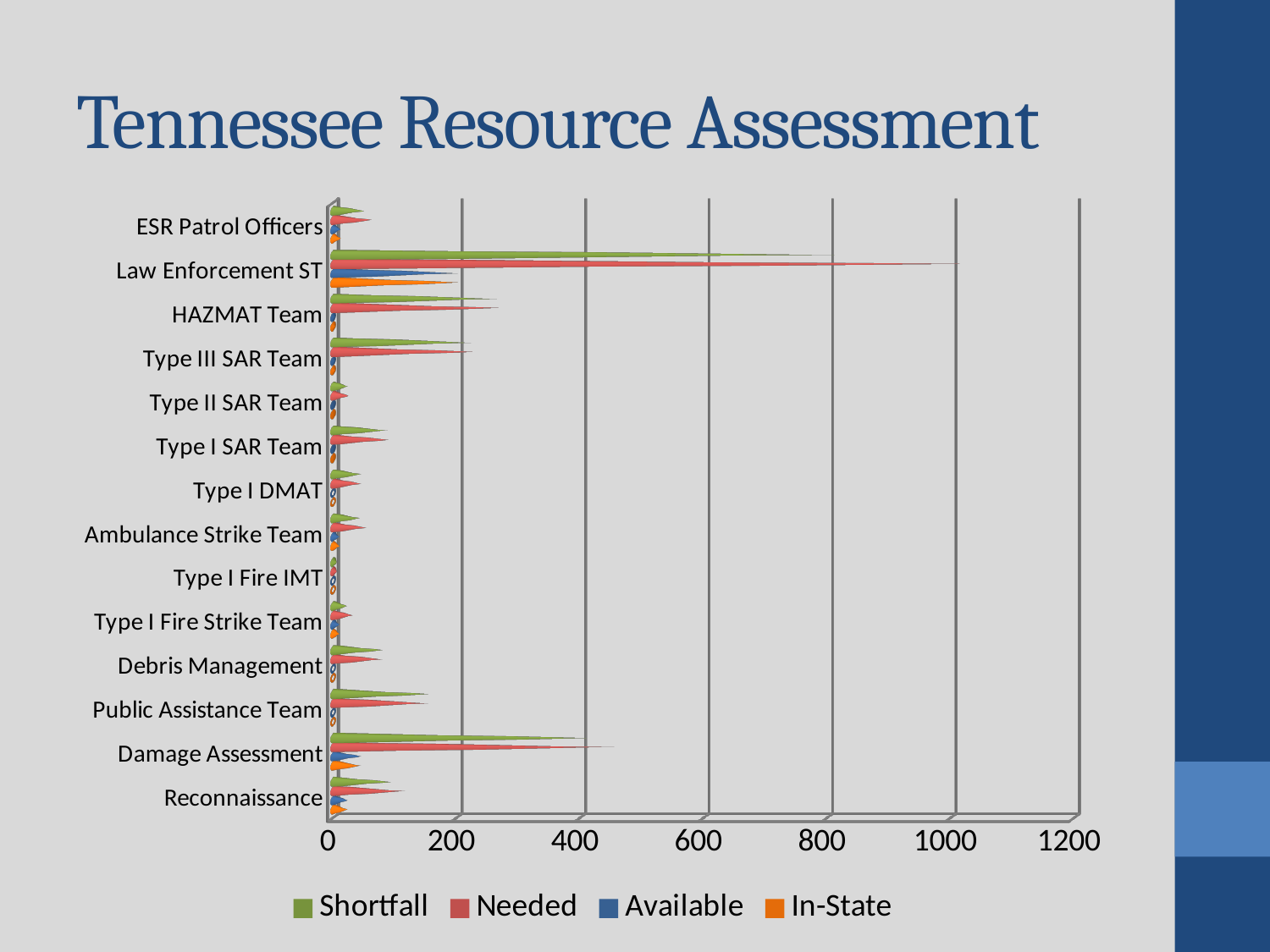
Which colour represents the In-State series in the legend? orange Which has the larger Needed value, Law Enforcement ST or Damage Assessment? Law Enforcement ST Is the Needed value for HAZMAT Team greater or less than 200? greater What is the title of the chart? Tennessee Resource Assessment Which category has the highest Needed value? Law Enforcement ST Is the Needed value for Damage Assessment greater or less than 400? greater How many series does the legend list? 4 How many categories are shown on the vertical axis of the chart? 14 Is the Needed value for Public Assistance Team greater or less than 200? less What kind of chart is shown on the slide? bar chart Which category has the highest Shortfall value? Law Enforcement ST